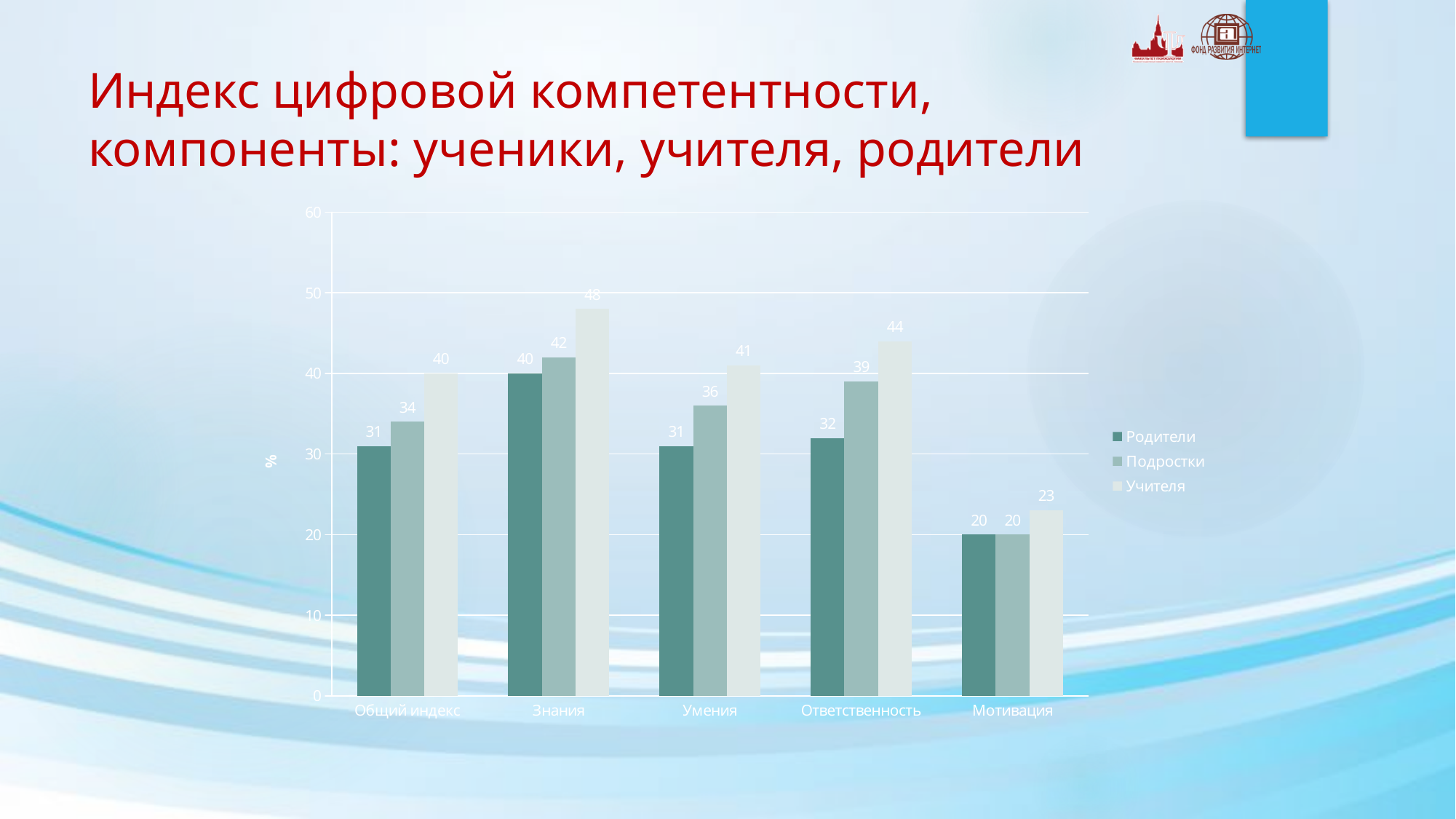
What label is shown on the vertical axis? % How many categories are shown on the x axis? 5 What kind of chart is shown on the slide? bar chart What is the value for Родители in the Общий индекс category? 31 Which category has the lowest value for Подростки? Мотивация Which is larger: the Подростки value for Умения or the Подростки value for Общий индекс? Умения Is the value for Учителя in the Умения category greater or less than 40? greater Which category has the highest value for Учителя? Знания How many series does the legend list? 3 What is the value for Подростки in the Ответственность category? 39 What is the value for Учителя in the Знания category? 48 What is the difference between the Учителя and Родители values in the Ответственность category? 12